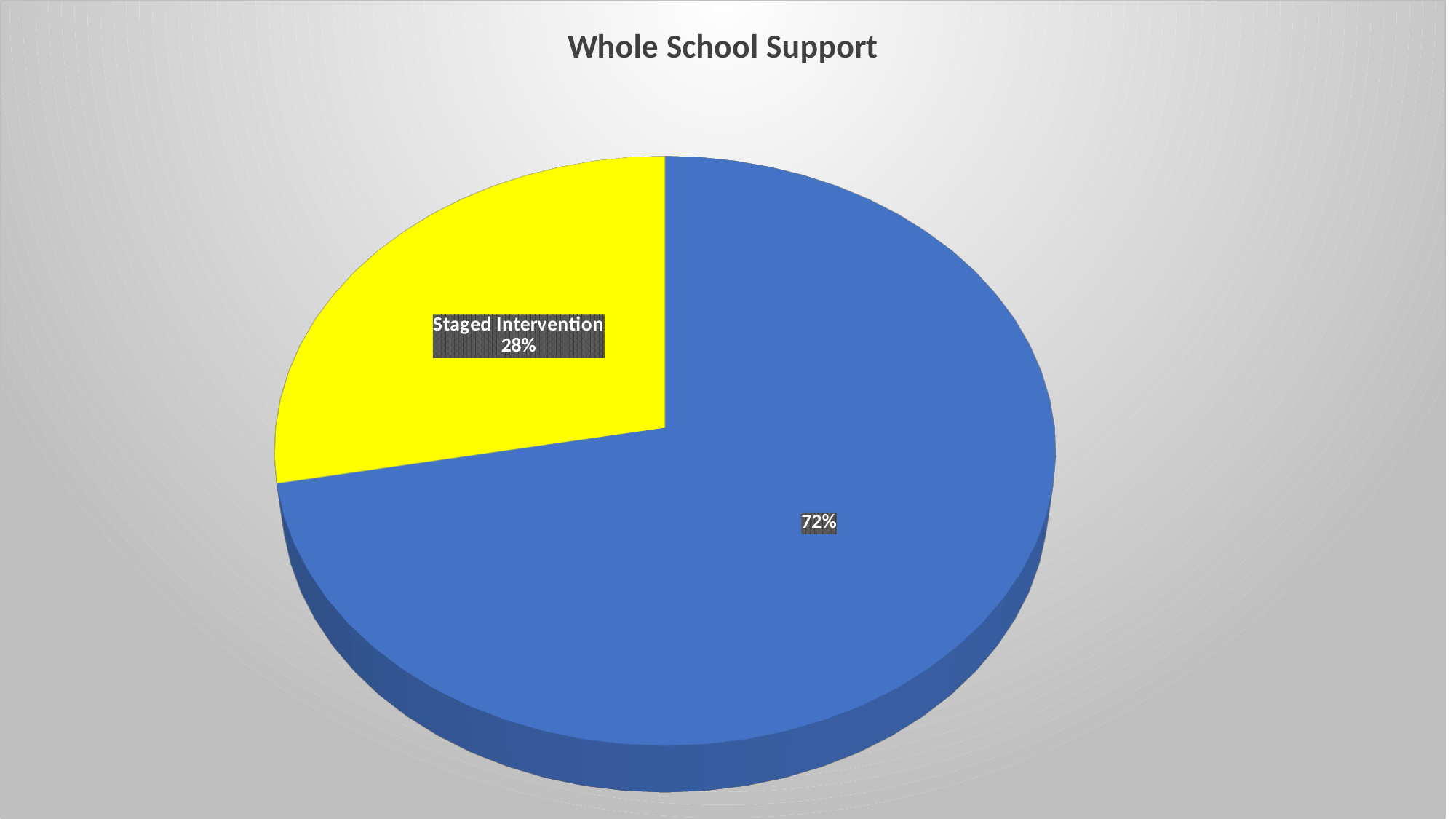
What is the title of the chart? Whole School Support What colour is the Staged Intervention slice? yellow What percentage is shown on the blue slice of the pie? 72% What type of chart is shown on the slide? pie chart What is the difference in percentage points between the blue slice and the Staged Intervention slice? 44 Which slice is larger, the yellow Staged Intervention slice or the blue slice? the blue slice Which slice of the pie is the smallest? Staged Intervention Is the share for Staged Intervention greater or less than 50%? less How many slices does the pie chart have? 2 What percentage of the pie does Staged Intervention represent? 28%